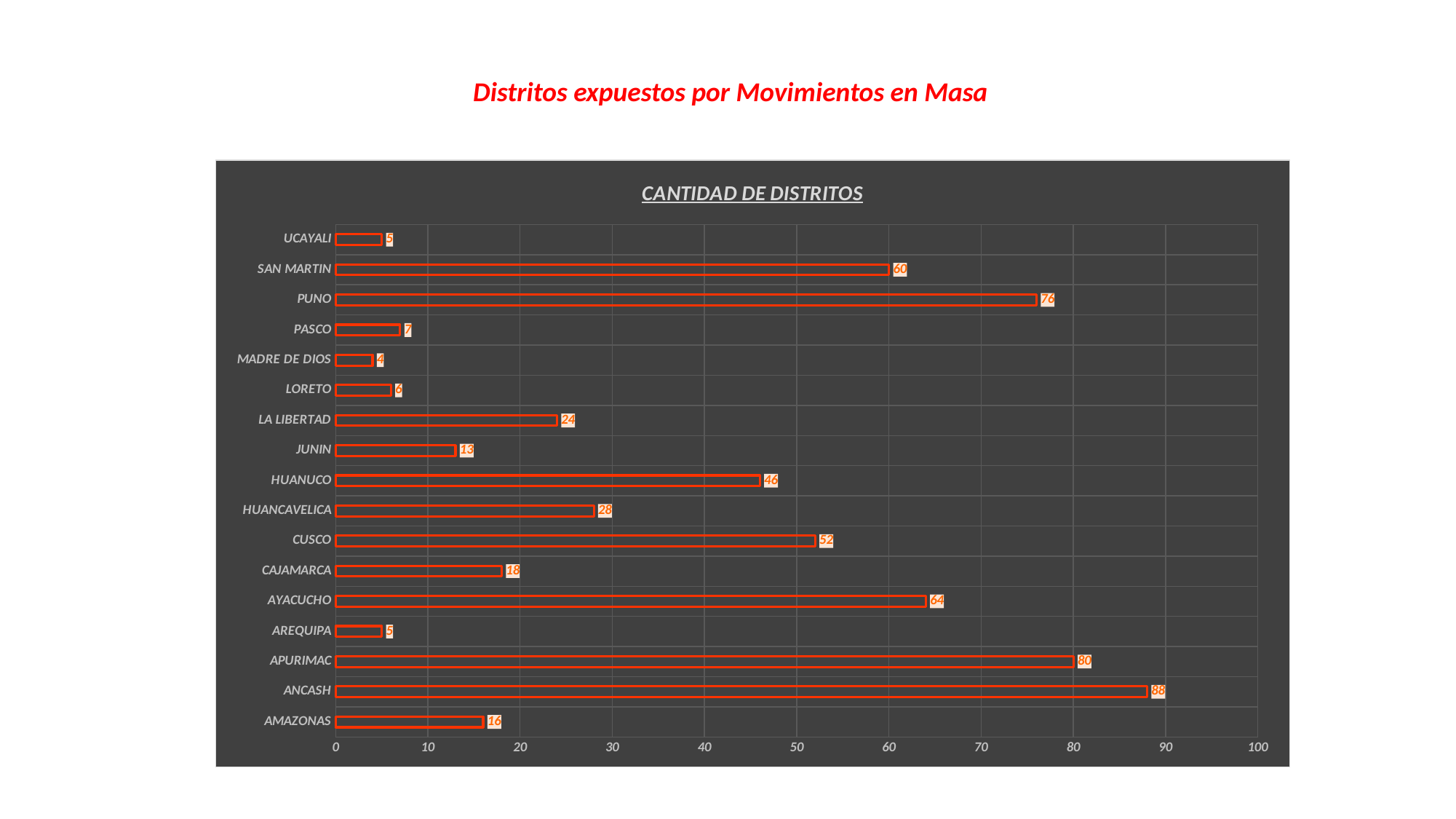
What is the difference between the values for CUSCO and HUANUCO? 6 What kind of chart is shown on the slide? Bar chart What is the difference between the values for ANCASH and APURIMAC? 8 What is the title of the chart? CANTIDAD DE DISTRITOS What is the value for MADRE DE DIOS? 4 How many categories are shown on the chart? 17 What is the value for PUNO? 76 What is the value for HUANCAVELICA? 28 Which category has the highest value? ANCASH Which is larger, the value for SAN MARTIN or the value for AYACUCHO? AYACUCHO Which is larger, the value for LA LIBERTAD or the value for CAJAMARCA? LA LIBERTAD Which category has the lowest value? MADRE DE DIOS